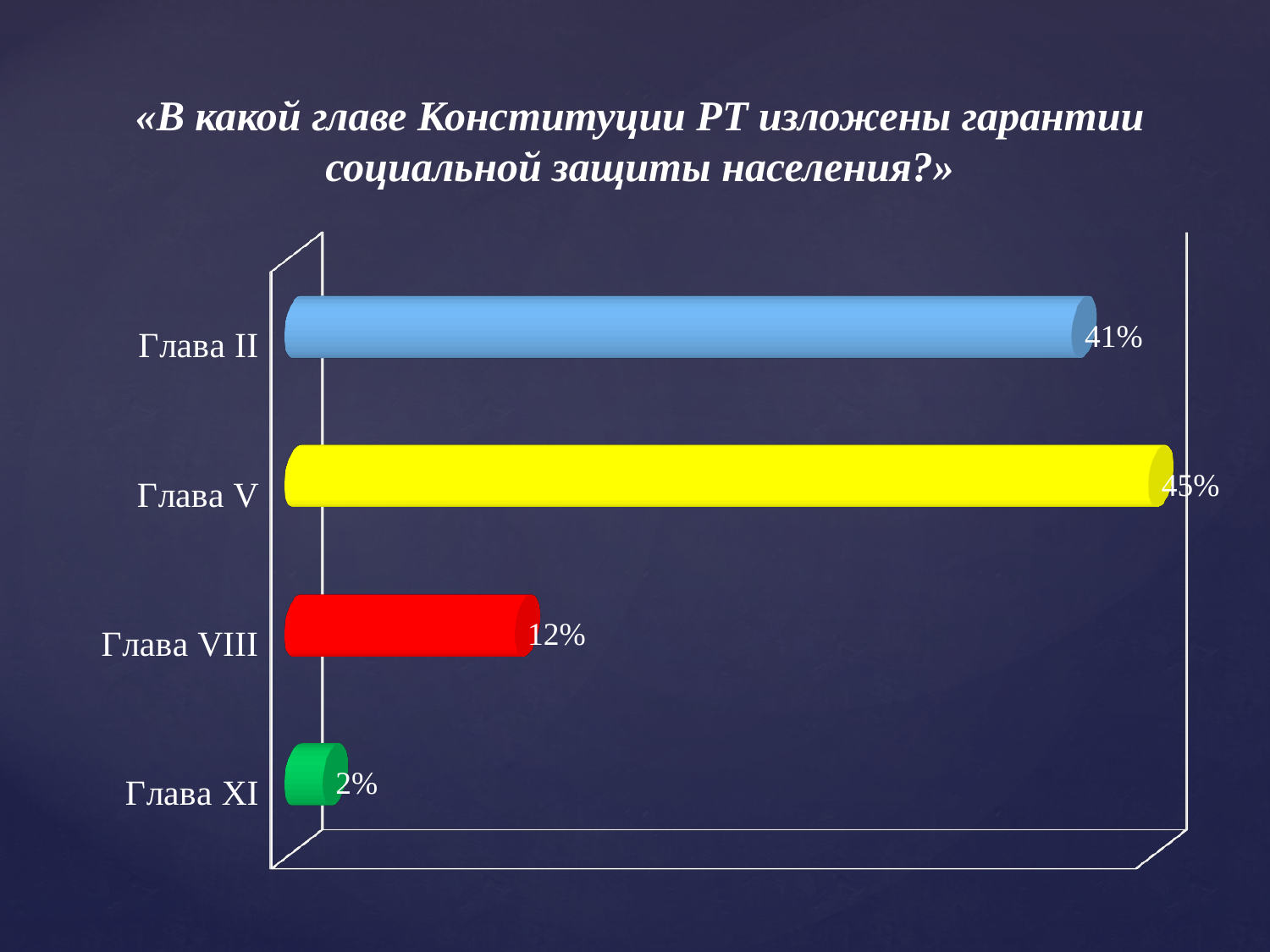
Which is larger, the value for Глава II or the value for Глава VIII? Глава II What is the difference between the values for Глава V and Глава II? 4% What is the value for Глава VIII? 12% What kind of chart is shown on the slide? Bar chart What is the difference between the values for Глава VIII and Глава XI? 10% How many categories are shown in the chart? 4 What colour is the bar for Глава V? Yellow What is the value for Глава II? 41% What is the value for Глава V? 45% Which category has the lowest value? Глава XI Which category has the highest value? Глава V What is the value for Глава XI? 2%